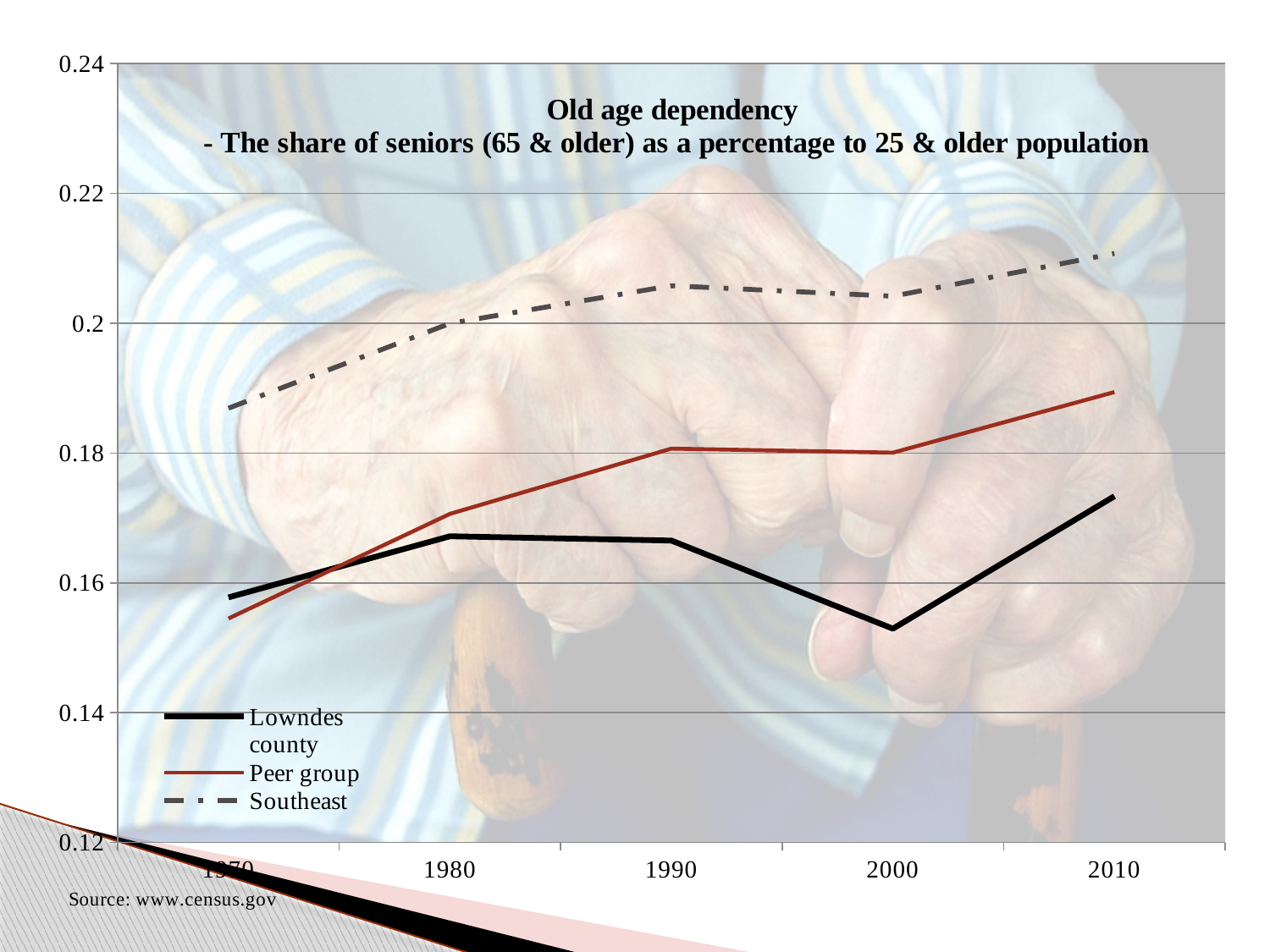
What kind of chart is shown on the slide? line chart Is the value for Lowndes county in 2010 greater or less than 0.18? less Which series has the highest value in 2010? Southeast Does the Lowndes county line rise or fall from 1990 to 2000? fall Which series does the dash-dot line represent? Southeast How many series does the legend list? 3 Is the value for Peer group in 2010 greater or less than 0.18? greater Is the value for Lowndes county in 2000 greater or less than 0.16? less In 2000, which is larger, the Peer group value or the Lowndes county value? Peer group What source is cited below the chart? www.census.gov Which series has the lowest value in 2000? Lowndes county